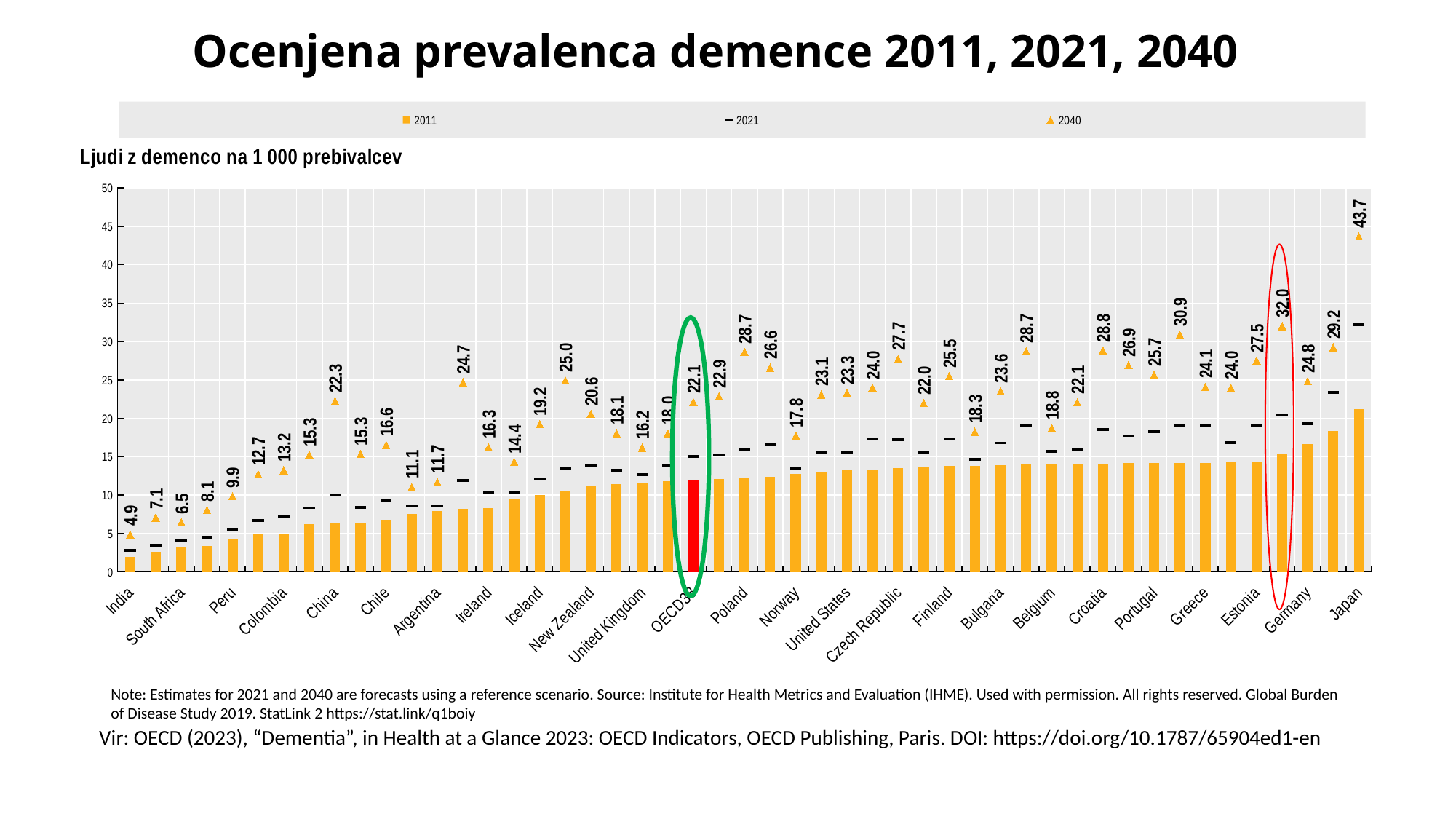
Do the 2011 bars generally rise or fall from left to right? rise Which has a larger 2040 value, Japan or OECD38? Japan Which category is shown with a red bar? OECD38 What is the 2040 value for India? 4.9 Which country has the lowest 2040 value? India What is the 2040 value for OECD38? 22.1 Which country has the highest 2040 value? Japan How many series does the legend list? 3 What is the difference between the 2040 values for Japan and India? 38.8 What is the 2040 value for Japan? 43.7 Is the 2021 value for Japan greater or less than 30? greater Is the 2011 value for India greater or less than 5? less